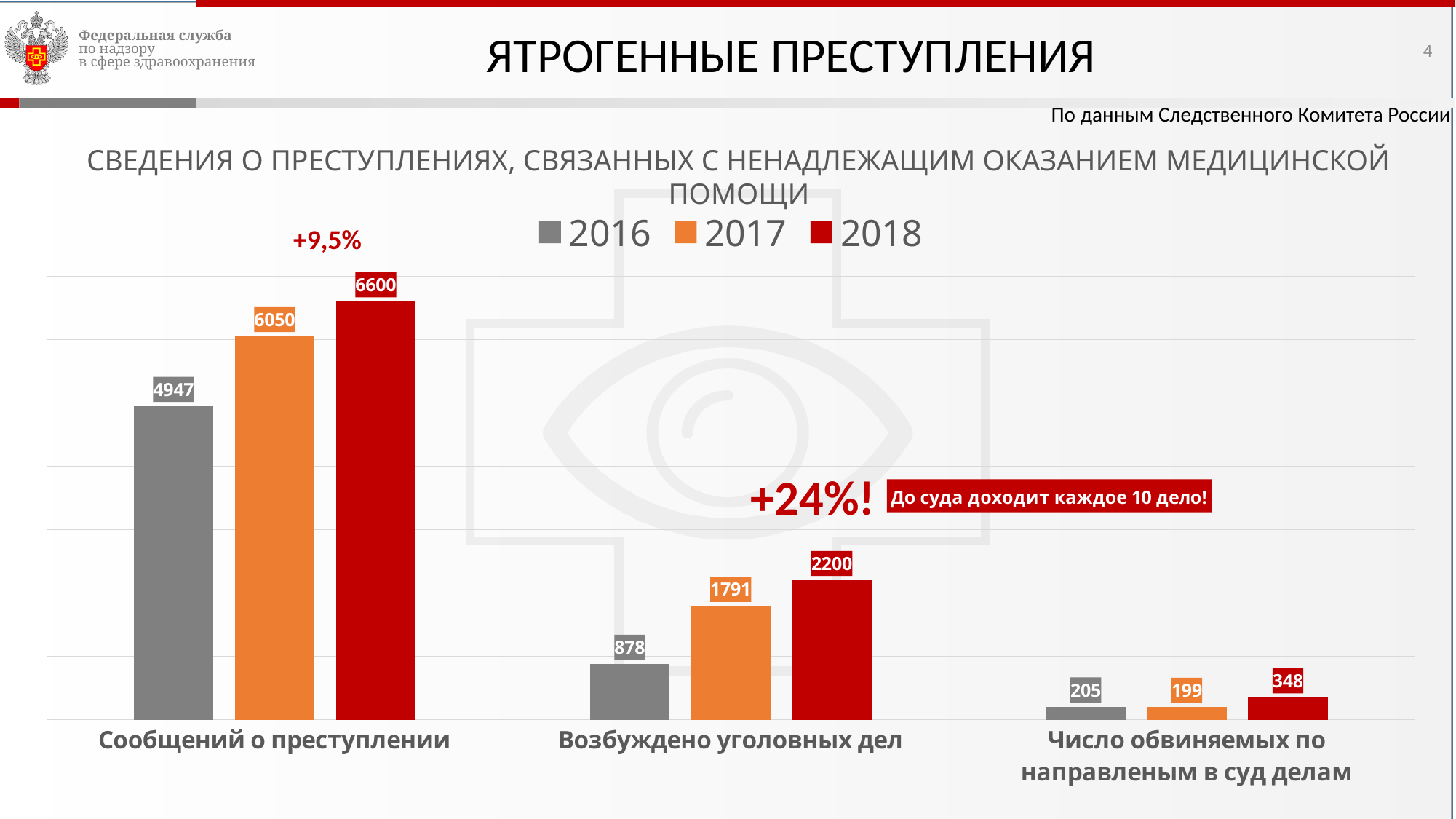
How many series does the legend list? 3 Which year had the highest value for 'Возбуждено уголовных дел'? 2018 What is the difference between the 2018 and 2016 values for 'Возбуждено уголовных дел'? 1322 Which category had the lowest value in 2016? Число обвиняемых по направленым в суд делам What was the value for 'Сообщений о преступлении' in 2018? 6600 What was the value for 'Возбуждено уголовных дел' in 2016? 878 How many categories are shown on the x axis? 3 Which colour represents the 2017 series in the legend? Orange Which is larger: the 2016 value or the 2017 value for 'Число обвиняемых по направленым в суд делам'? 2016 What was the value for 'Число обвиняемых по направленым в суд делам' in 2017? 199 What kind of chart is shown on the slide? Bar chart What is the difference between the 2018 and 2017 values for 'Сообщений о преступлении'? 550